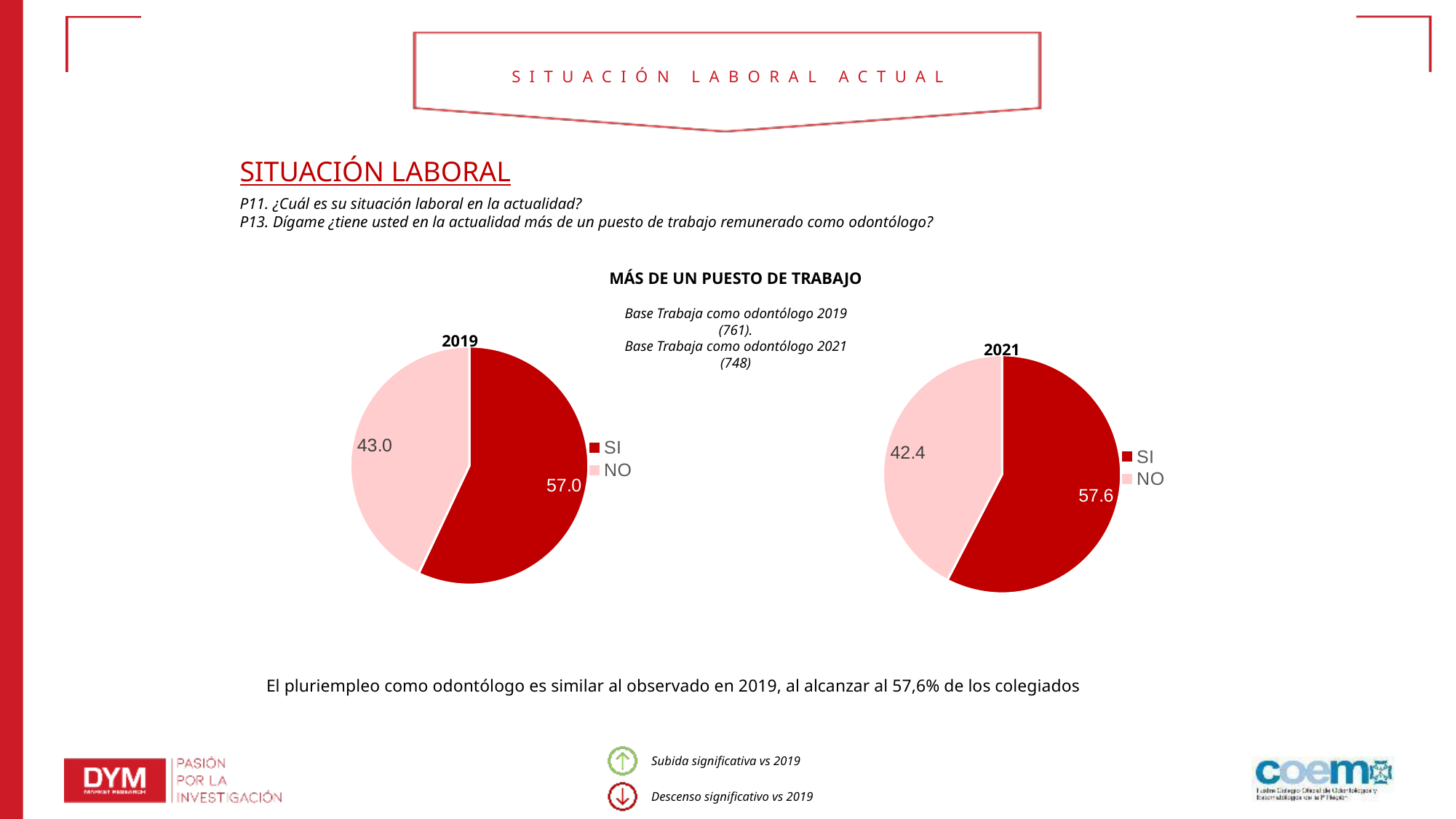
What kind of chart is used to show the 2021 data? Pie chart In the 2019 pie chart, what is the value for NO? 43.0 In the 2021 pie chart, what is the value for SI? 57.6 In the 2021 pie chart, what is the value for NO? 42.4 In the 2021 pie chart, which slice is the largest? SI In the 2019 pie chart, what is the difference between the SI and NO values? 14.0 How many entries does the legend of the 2021 pie chart list? 2 Comparing the two pie charts, is the SI value larger in 2019 or in 2021? 2021 How many slices does the 2019 pie chart have? 2 In the 2019 pie chart, what is the value for SI? 57.0 In the 2021 pie chart, what is the difference between the SI and NO values? 15.2 In the 2019 pie chart, which slice is the smallest? NO